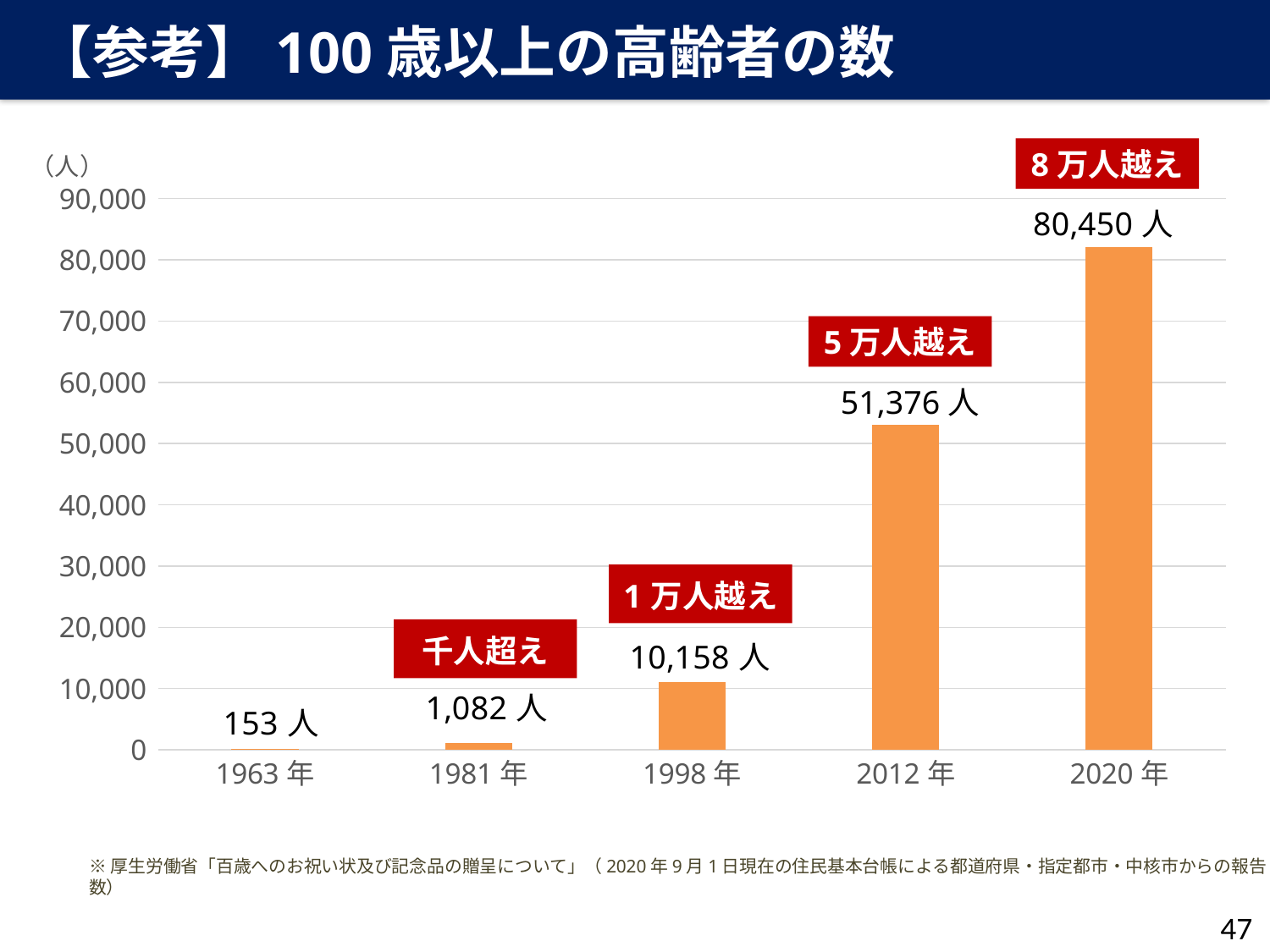
Which is larger, the value for 2012 年 or the value for 1998 年? 2012 年 Which year has the lowest value? 1963 年 What is the value for 2020 年? 80,450 人 What is the difference between the values for 2020 年 and 2012 年? 29,074 人 What is the difference between the values for 1998 年 and 1981 年? 9,076 人 What is the value for 2012 年? 51,376 人 What is the value for 1963 年? 153 人 Which year has the highest value? 2020 年 What is the value for 1998 年? 10,158 人 What kind of chart is shown on the slide? Bar chart Do the values rise or fall from 1963 年 to 2020 年? Rise How many years are shown on the x axis? 5